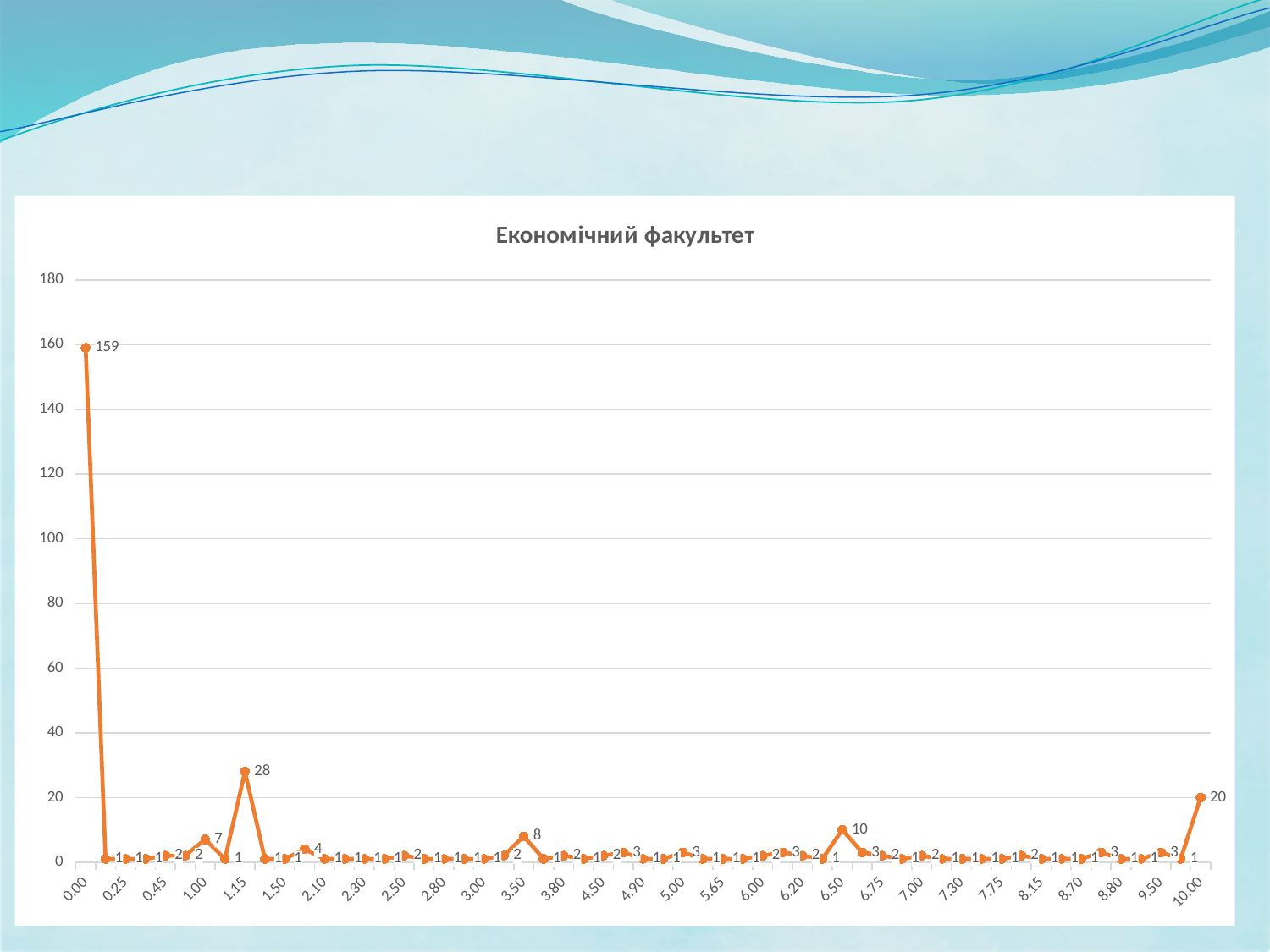
What is the value at 6.50? 10 What is the value at 3.50? 8 What is the difference between the value at 0.00 and the value at 1.15? 131 Is the value at 0.00 greater or less than 140? greater What is the value at 1.15? 28 What kind of chart is shown on the slide? line chart Which is larger, the value at 1.15 or the value at 10.00? 1.15 Which x-axis category has the highest value? 0.00 What is the title of the chart? Економічний факультет What is the value at 0.00? 159 What is the value at 10.00? 20 What is the value at 1.00? 7